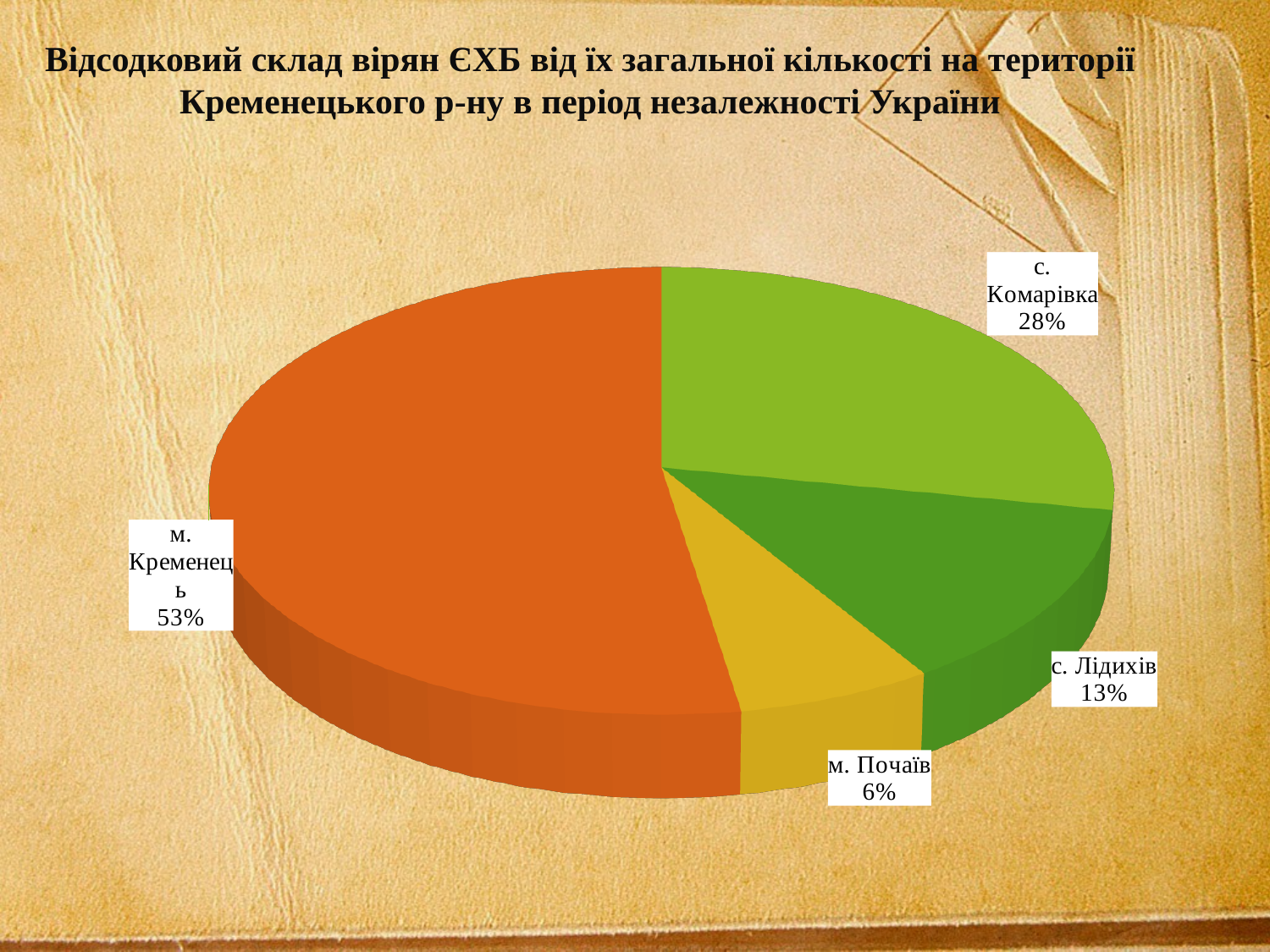
Which is larger, the share for с. Лідихів or the share for м. Почаїв? с. Лідихів How many slices does the pie chart have? 4 What share of the pie does м. Кременець have? 53% What is the combined share of с. Комарівка and с. Лідихів? 41% What share of the pie does с. Лідихів have? 13% What is the difference in percentage points between м. Кременець and с. Комарівка? 25 What share of the pie does м. Почаїв have? 6% Which category has the smallest slice of the pie? м. Почаїв What colour is the slice for м. Кременець? orange What kind of chart is shown on the slide? pie chart Which category has the largest slice of the pie? м. Кременець